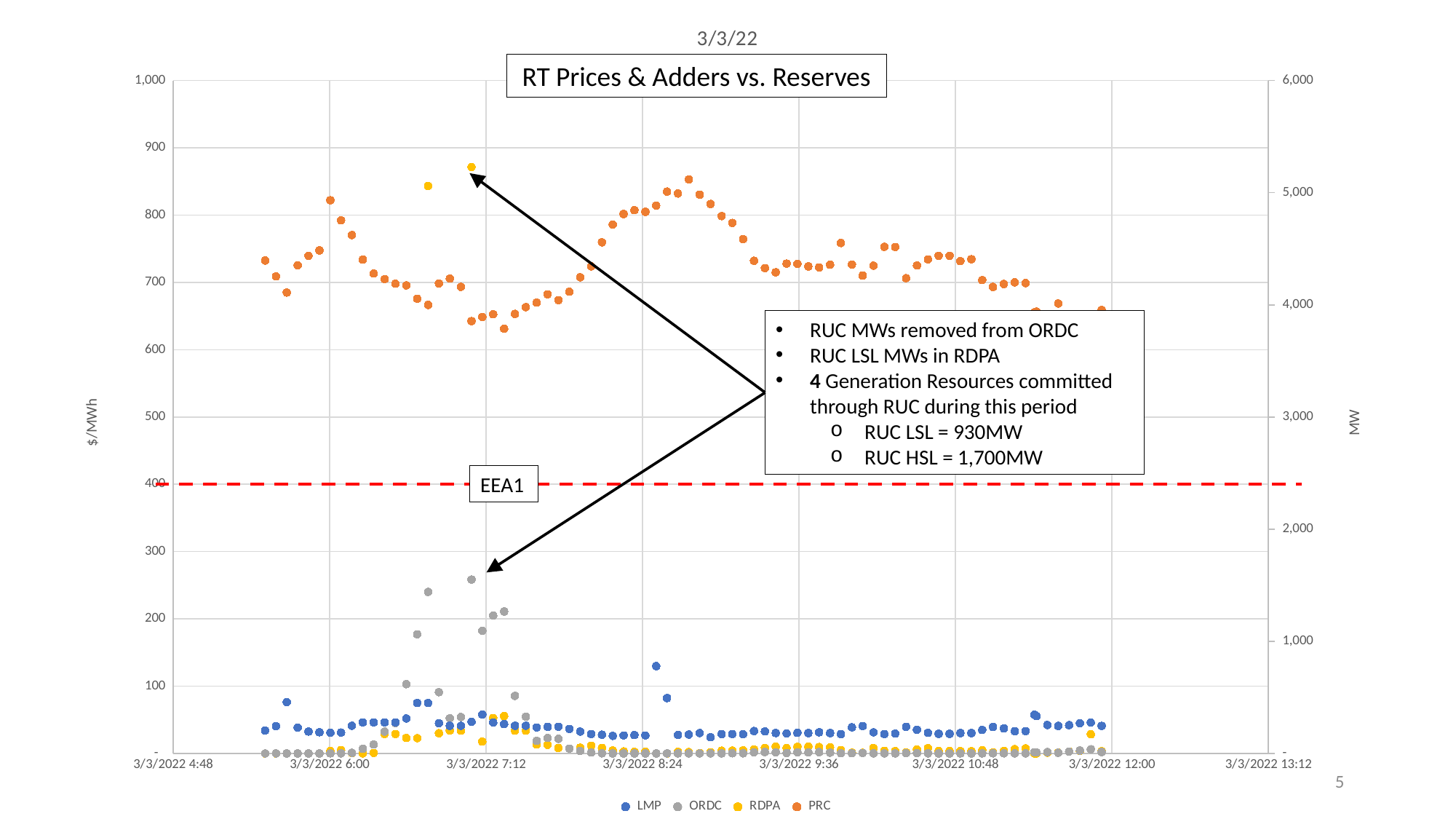
Is the highest RDPA point on the chart greater or less than 800 on the $/MWh axis? greater Is the lowest PRC point on the chart greater or less than 4,000 on the right-hand MW axis? less Is the highest ORDC value on the chart greater or less than 200 on the $/MWh axis? greater What kind of chart is shown on the slide? Scatter chart Do the PRC values rise or fall between 3/3/2022 8:24 and 3/3/2022 9:36? fall What is the title of the chart? RT Prices & Adders vs. Reserves What label is shown on the red dashed horizontal line? EEA1 Which series reaches a higher peak on the chart, RDPA or ORDC? RDPA Do the PRC values rise or fall between 3/3/2022 7:12 and 3/3/2022 8:24? rise How many series does the chart legend list? 4 Which series reaches a higher peak on the $/MWh axis, ORDC or LMP? ORDC